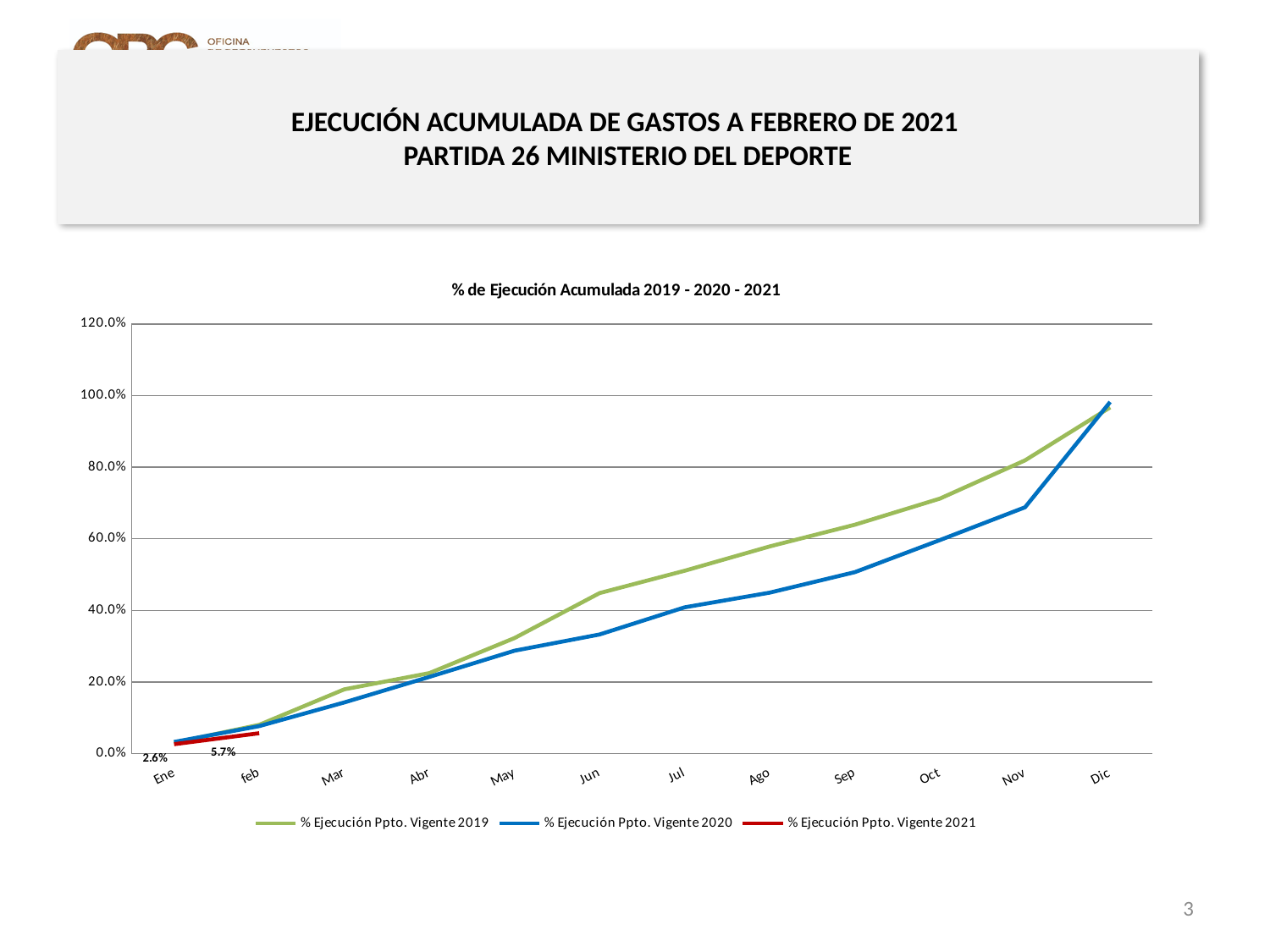
By how many percentage points did % Ejecución Ppto. Vigente 2021 increase from Ene to feb? 3.1 percentage points Do the values for % Ejecución Ppto. Vigente 2019 rise or fall from Ene to Dic? Rise What is the title of the chart? % de Ejecución Acumulada 2019 - 2020 - 2021 How many series does the legend list? 3 Is the value for % Ejecución Ppto. Vigente 2020 in Nov greater or less than 80.0%? less What is the value of % Ejecución Ppto. Vigente 2021 in Ene? 2.6% Is the value for % Ejecución Ppto. Vigente 2019 in Jun greater or less than 40.0%? greater What kind of chart is shown on the slide? Line chart How many months are shown on the x axis? 12 What is the value of % Ejecución Ppto. Vigente 2021 in feb? 5.7% In Oct, which series has the higher value: % Ejecución Ppto. Vigente 2019 or % Ejecución Ppto. Vigente 2020? % Ejecución Ppto. Vigente 2019 Which colour is used for the % Ejecución Ppto. Vigente 2021 series? Red